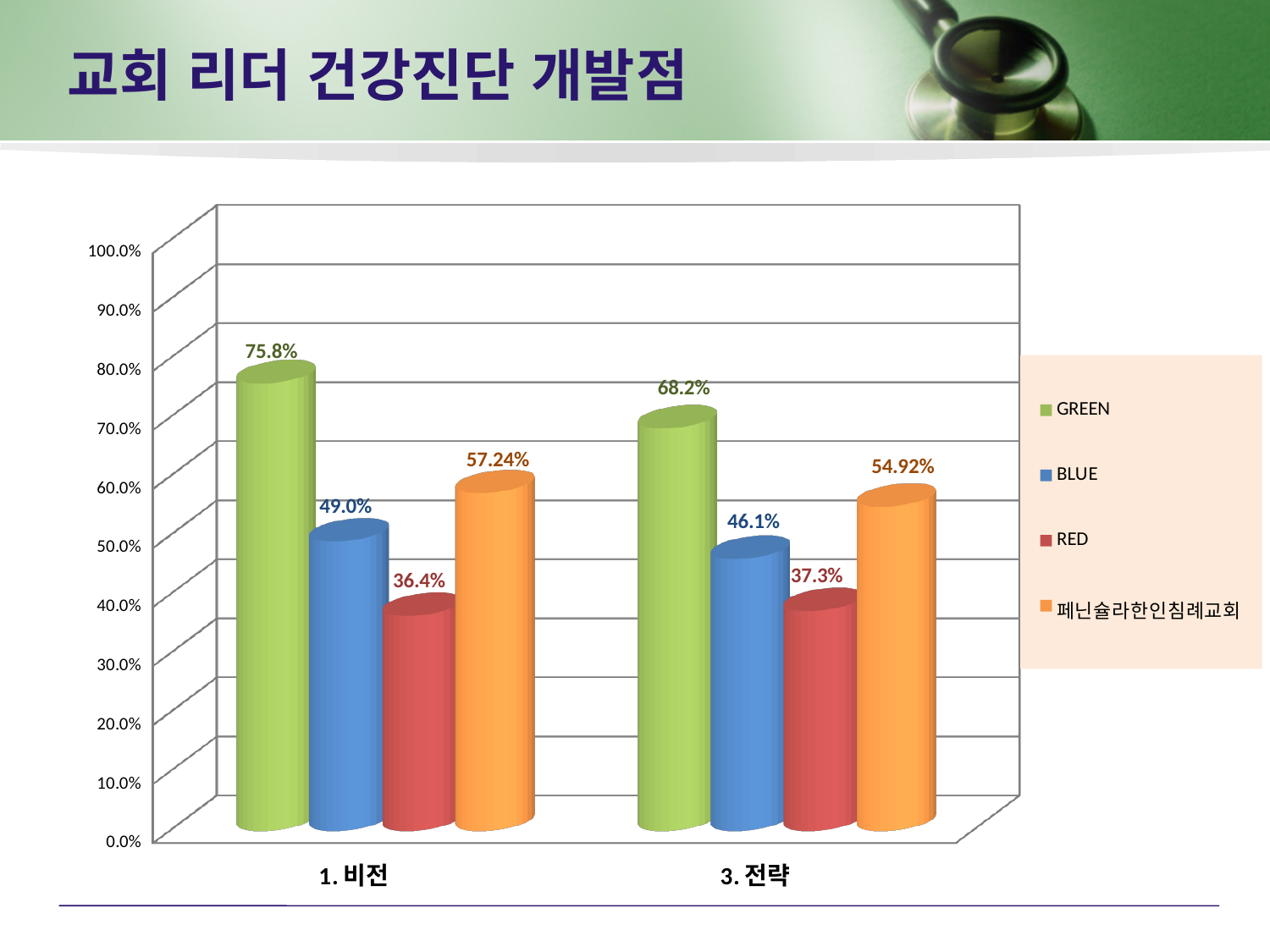
Which series has the highest value in the 3. 전략 category? GREEN What is the difference between the GREEN values for 1. 비전 and 3. 전략? 7.6% What is the value for RED in the 1. 비전 category? 36.4% How many categories are shown on the x axis? 2 Which series has the lowest value in the 1. 비전 category? RED What is the value for GREEN in the 1. 비전 category? 75.8% Which is larger: the BLUE value for 1. 비전 or the BLUE value for 3. 전략? 1. 비전 How many series does the legend list? 4 What is the value for 페닌슐라한인침례교회 in the 3. 전략 category? 54.92% What kind of chart is shown on the slide? Bar chart What colour represents the 페닌슐라한인침례교회 series in the legend? Orange What is the value for BLUE in the 3. 전략 category? 46.1%